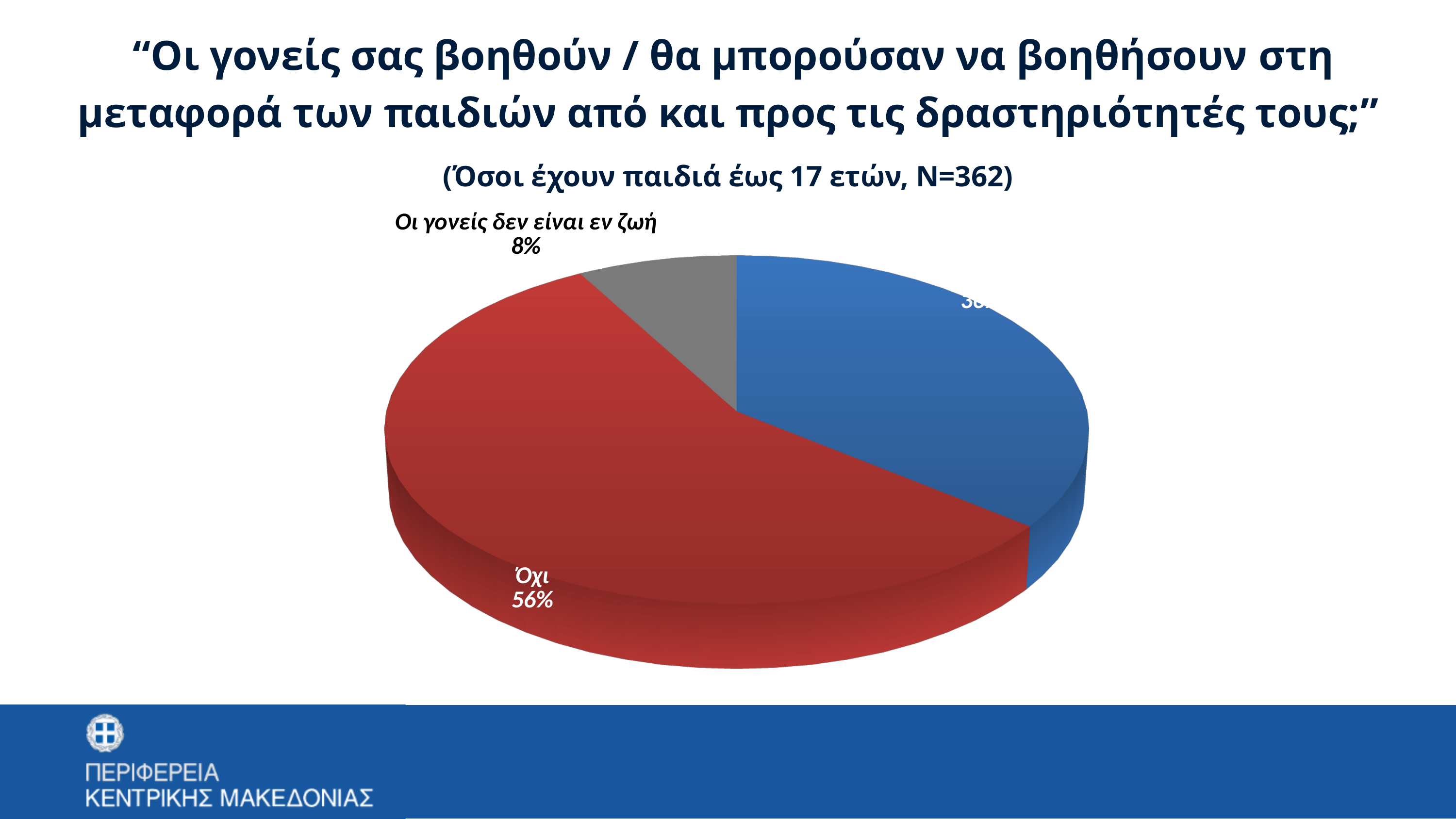
What share of the pie does the "Όχι" slice take? 56% Which slice of the pie chart is the largest? Όχι Which slice of the pie chart is the smallest? Οι γονείς δεν είναι εν ζωή What sample size (N) is stated in the chart subtitle? N=362 What is the difference in percentage points between the "Όχι" slice and the "Οι γονείς δεν είναι εν ζωή" slice? 48 Which is larger, the "Όχι" slice or the "Οι γονείς δεν είναι εν ζωή" slice? Όχι How many slices does the pie chart have? 3 What colour is the "Όχι" slice? red What percentage does the "Οι γονείς δεν είναι εν ζωή" slice represent? 8% What percentage does the "Όχι" slice represent? 56% What kind of chart is shown on the slide? pie chart